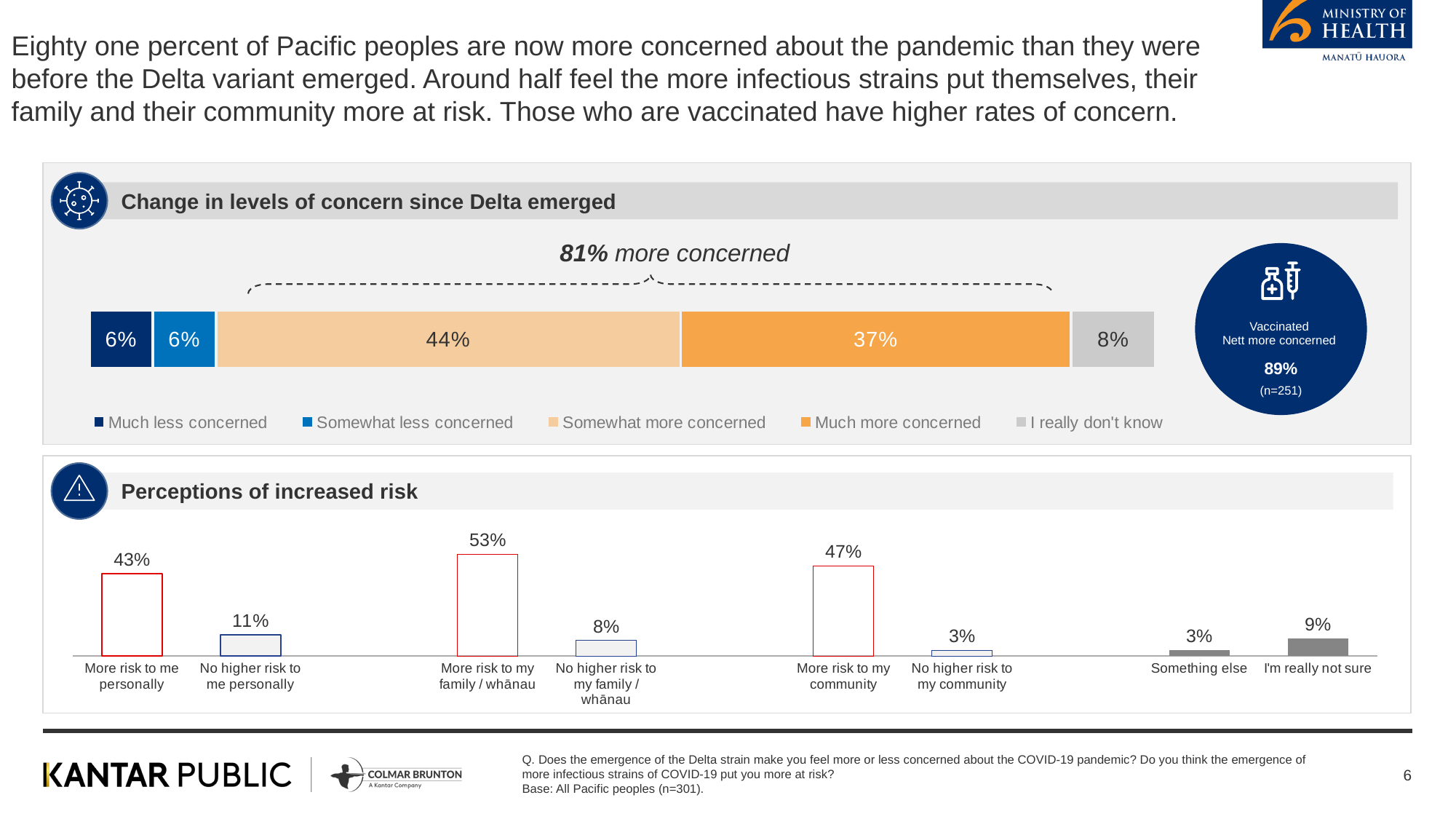
In the 'Perceptions of increased risk' chart, how many categories are shown? 8 In the 'Change in levels of concern since Delta emerged' chart, what percentage are 'Somewhat more concerned'? 44% In the 'Change in levels of concern since Delta emerged' chart, what percentage are 'Much more concerned'? 37% In the 'Perceptions of increased risk' chart, what is the difference between 'More risk to me personally' and 'No higher risk to me personally'? 32% In the 'Change in levels of concern since Delta emerged' chart, what is the difference between 'Somewhat more concerned' and 'Much more concerned'? 7% What kind of chart is the 'Perceptions of increased risk' chart? Bar chart In the 'Perceptions of increased risk' chart, what is the value for 'No higher risk to my community'? 3% In the 'Perceptions of increased risk' chart, what is the value for 'More risk to my family / whānau'? 53% In the 'Change in levels of concern since Delta emerged' chart, how many series does the legend list? 5 In the 'Change in levels of concern since Delta emerged' chart, what percentage answered 'I really don't know'? 8% In the 'Perceptions of increased risk' chart, which category has the highest value? More risk to my family / whānau In the 'Change in levels of concern since Delta emerged' chart, which category has the largest share? Somewhat more concerned